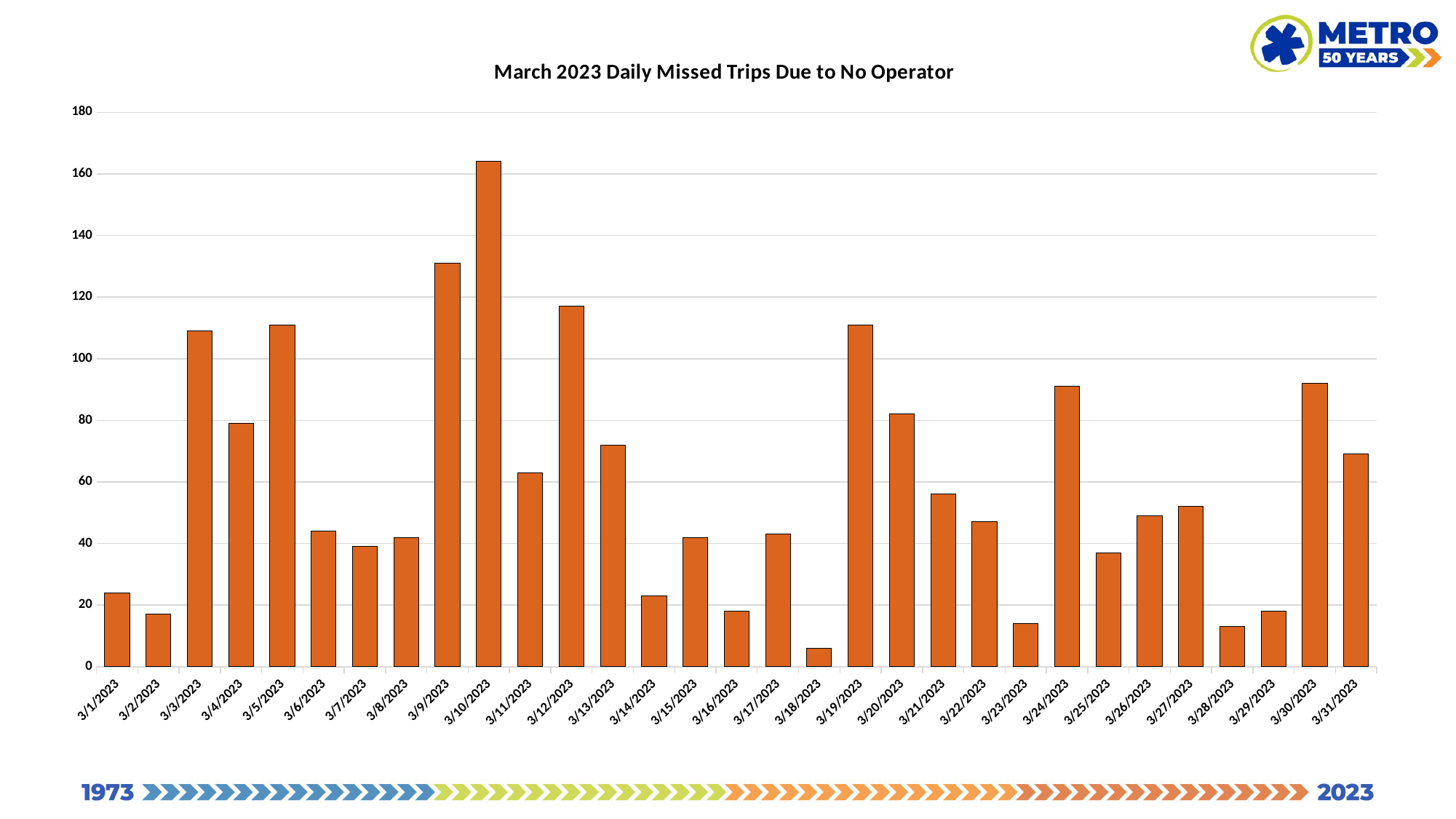
What type of chart is shown on the slide? bar chart How many dates (bars) are plotted on the chart? 31 Is the value for 3/18/2023 greater or less than 20? less Is the value for 3/10/2023 greater or less than 140? greater Which date has more missed trips, 3/9/2023 or 3/12/2023? 3/9/2023 Is the value for 3/2/2023 greater or less than 20? less Which date has the highest number of missed trips? 3/10/2023 What is the title of the chart? March 2023 Daily Missed Trips Due to No Operator Which date has the lowest number of missed trips? 3/18/2023 Which date has more missed trips, 3/20/2023 or 3/21/2023? 3/20/2023